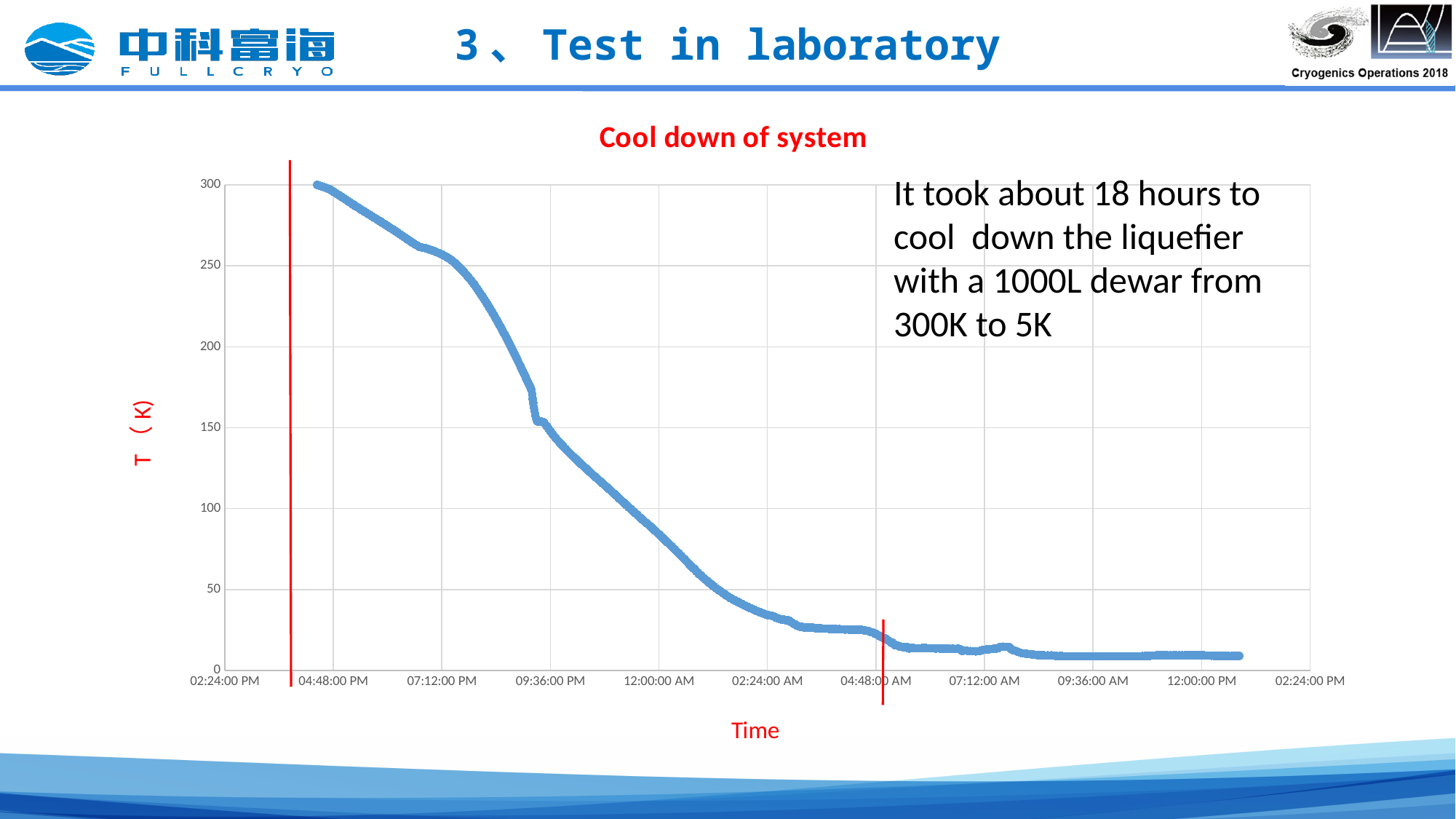
Is the temperature at 04:48:00 PM greater or less than 250? greater Is the temperature at 12:00:00 PM greater or less than 50? less Is the temperature at 02:24:00 AM greater or less than 50? less What is the label of the vertical axis of the chart? T (K) Do the plotted temperature values rise or fall along the time axis? fall What is the title of the chart? Cool down of system What kind of chart is shown on the slide? scatter chart